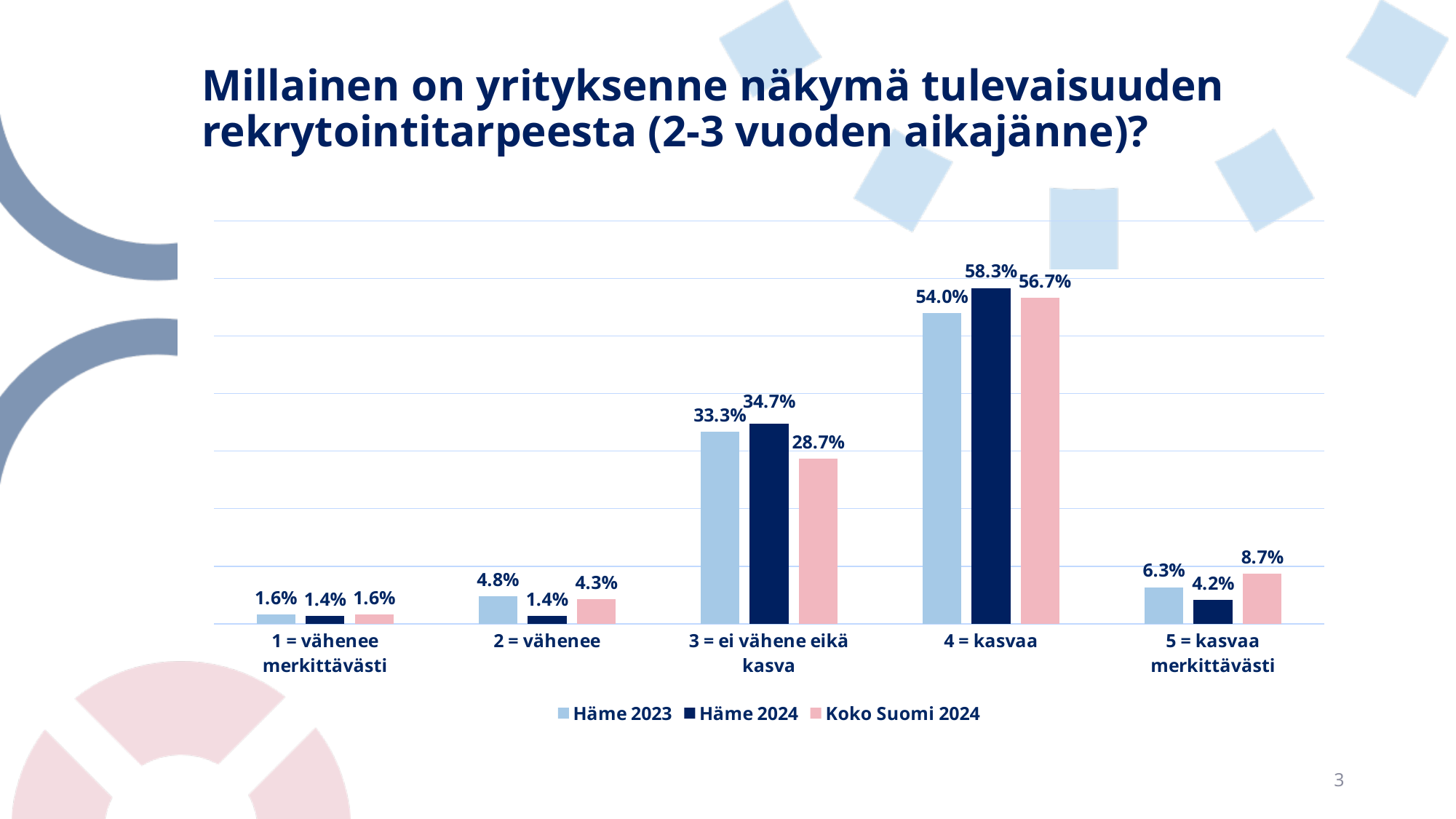
Which is larger in the category "2 = vähenee": Häme 2023 or Koko Suomi 2024? Häme 2023 What is the difference between Häme 2024 and Koko Suomi 2024 in the category "3 = ei vähene eikä kasva"? 6.0% What is the value for Häme 2024 in the category "4 = kasvaa"? 58.3% How many categories are shown on the x axis? 5 What is the value for Koko Suomi 2024 in the category "3 = ei vähene eikä kasva"? 28.7% How many series does the legend list? 3 What kind of chart is shown on the slide? Bar chart Which series is shown in pink in the legend? Koko Suomi 2024 Which category has the lowest value for Koko Suomi 2024? 1 = vähenee merkittävästi Which category has the highest value for Häme 2023? 4 = kasvaa What is the difference between Häme 2024 and Häme 2023 in the category "4 = kasvaa"? 4.3% What is the value for Häme 2023 in the category "5 = kasvaa merkittävästi"? 6.3%